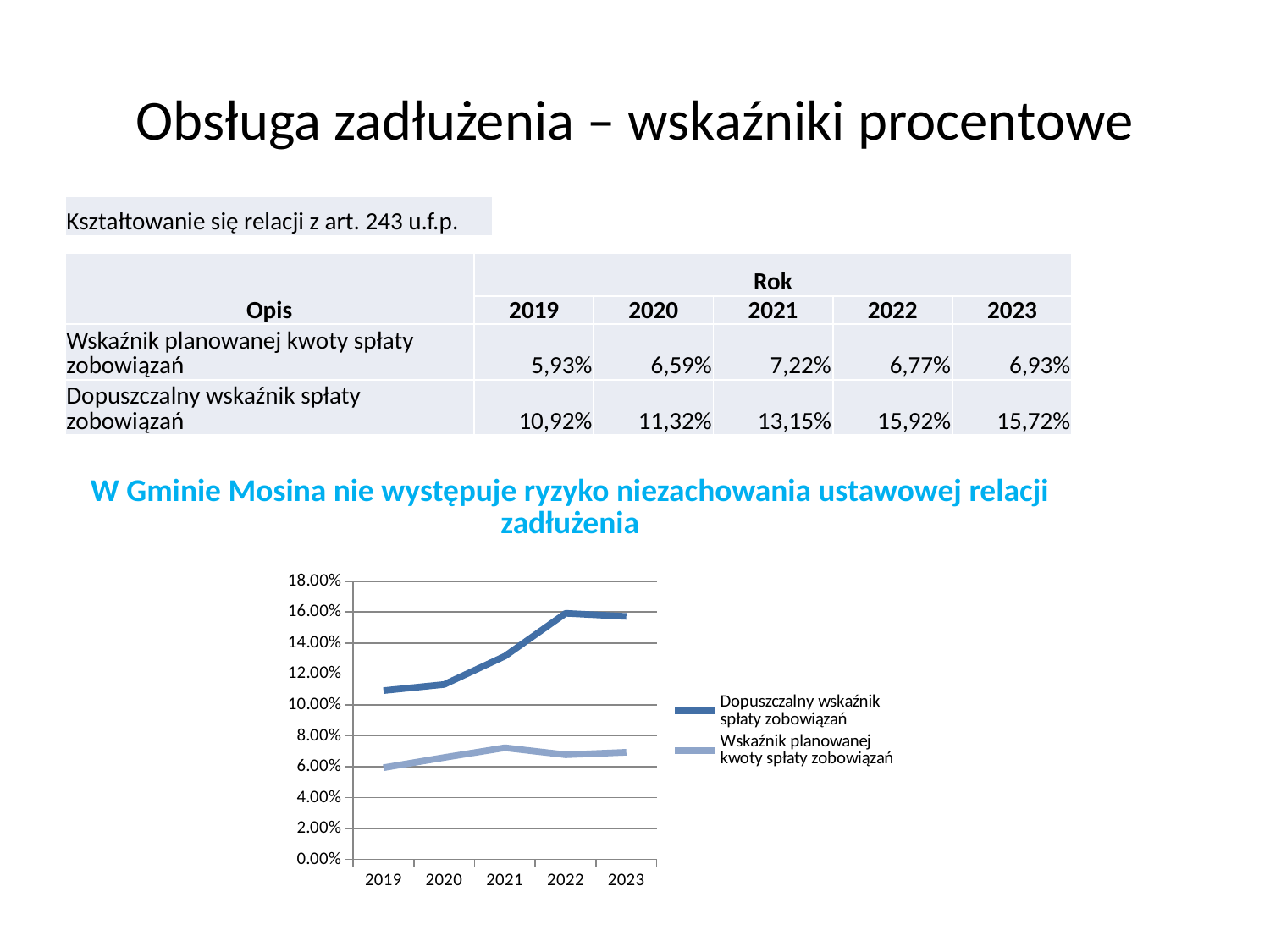
What is the difference between 'Dopuszczalny wskaźnik spłaty zobowiązań' and 'Wskaźnik planowanej kwoty spłaty zobowiązań' in 2022, using the values printed on the slide? 9,15% Is the value for 'Dopuszczalny wskaźnik spłaty zobowiązań' in 2021 greater or less than 12.00%? greater Is the value for 'Wskaźnik planowanej kwoty spłaty zobowiązań' in 2020 greater or less than 8.00%? less Which series is higher in 2023, 'Dopuszczalny wskaźnik spłaty zobowiązań' or 'Wskaźnik planowanej kwoty spłaty zobowiązań'? Dopuszczalny wskaźnik spłaty zobowiązań Does 'Dopuszczalny wskaźnik spłaty zobowiązań' generally rise or fall from 2019 to 2022? rise How many years are plotted along the x axis of the chart? 5 According to the slide, what is the value of 'Wskaźnik planowanej kwoty spłaty zobowiązań' for 2019? 5,93% In which year is 'Wskaźnik planowanej kwoty spłaty zobowiązań' highest? 2021 In which year is 'Dopuszczalny wskaźnik spłaty zobowiązań' lowest? 2019 What kind of chart is shown on the slide? line chart According to the slide, what is the value of 'Dopuszczalny wskaźnik spłaty zobowiązań' for 2022? 15,92% How many series does the chart legend list? 2